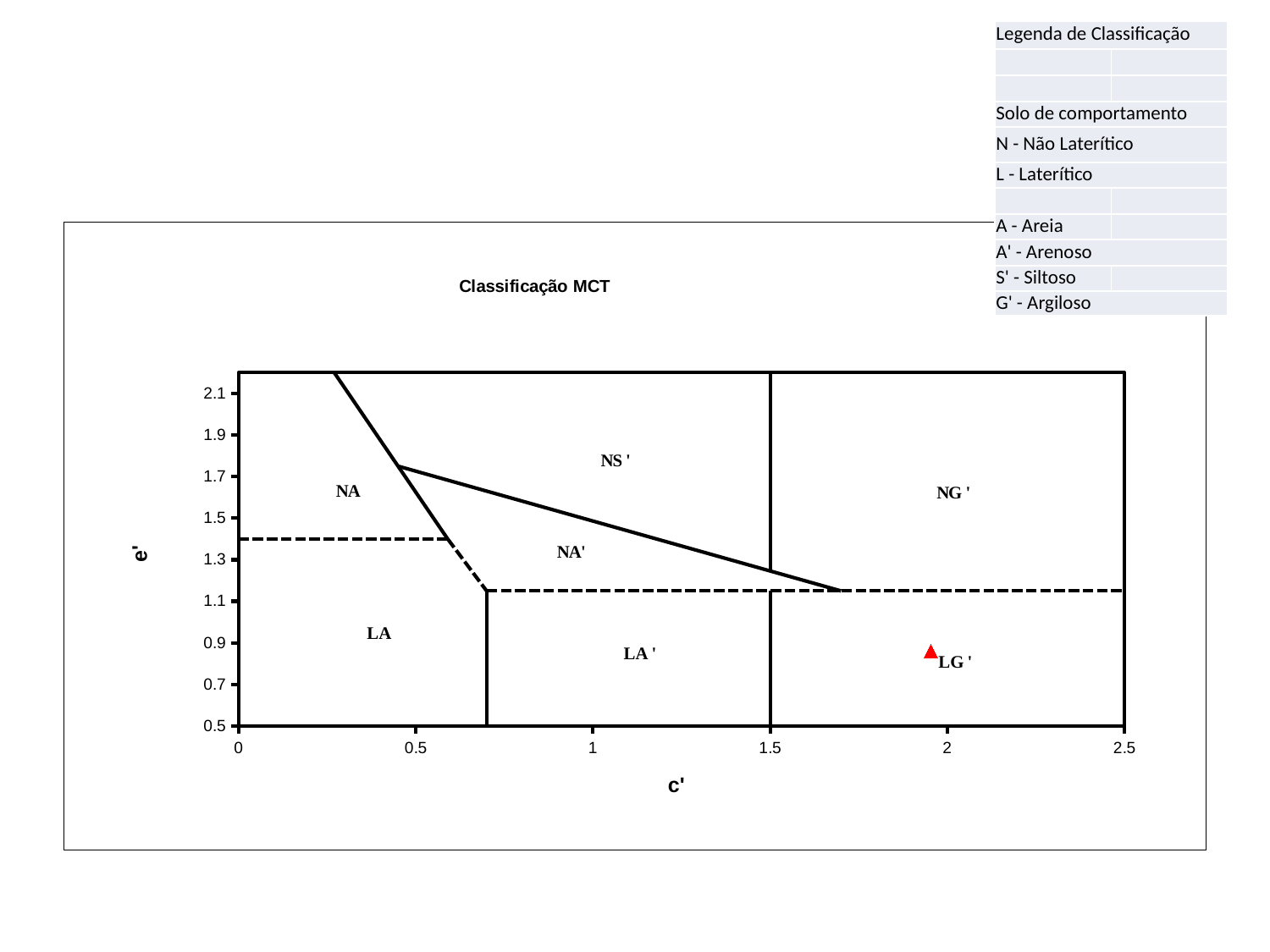
Is the e' value of the plotted point greater or less than 1.1? less Is the c' value of the plotted point greater or less than 1.5? greater How many data points are plotted on the chart? 1 What is the lowest value shown on the vertical axis? 0.5 How many classification regions are labelled inside the chart area? 7 What label is shown on the horizontal axis of the chart? c' In which classification region does the plotted red triangle fall? LG ' Is the c' value of the plotted point greater or less than 1? greater What is the highest value shown on the horizontal axis? 2.5 What is the title of the chart? Classificação MCT What kind of chart is shown on the slide? scatter chart